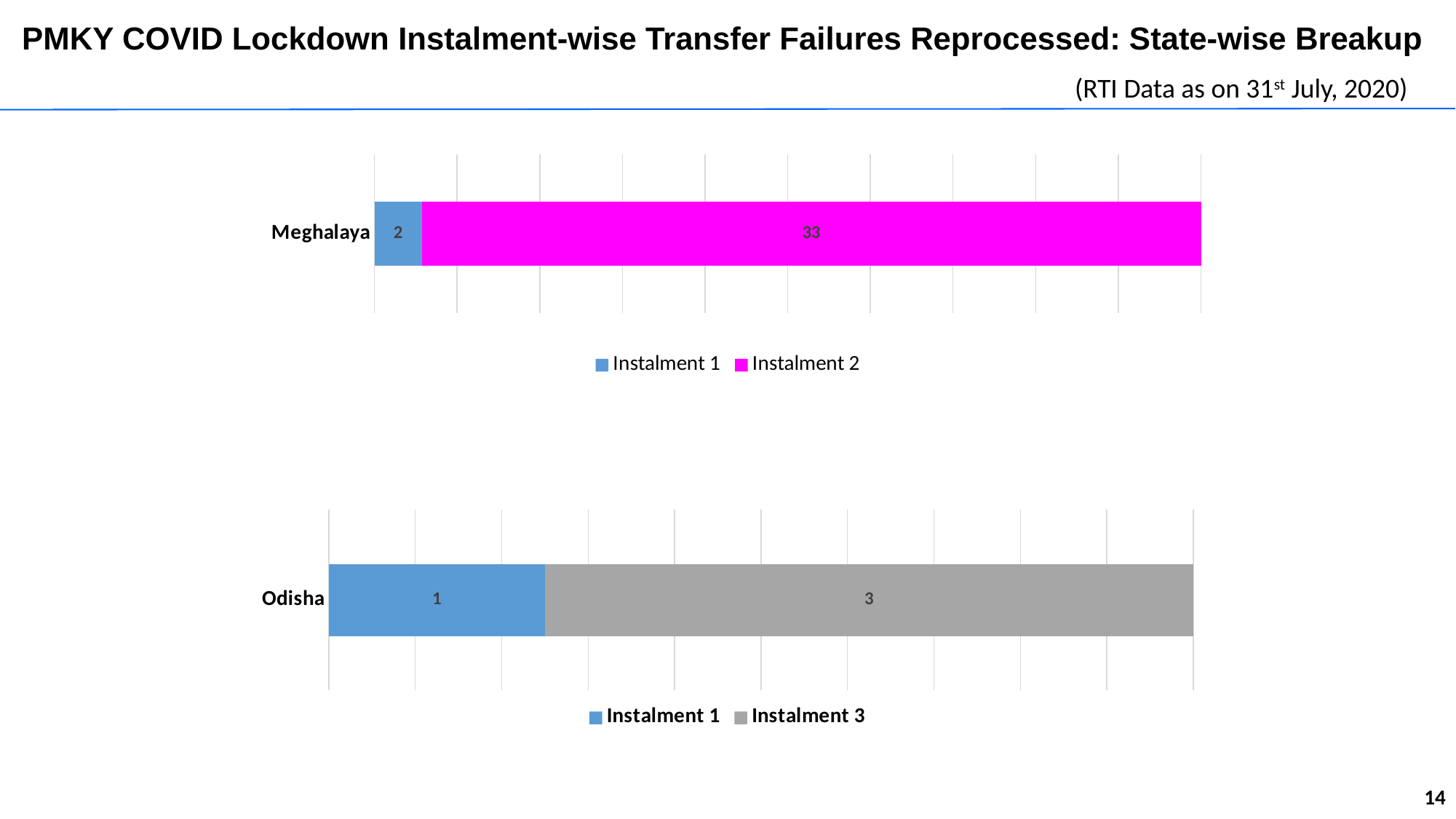
In the top chart (Meghalaya), what is the value for Instalment 1? 2 In the bottom chart (Odisha), what is the value for Instalment 1? 1 In the top chart (Meghalaya), which series has the highest value? Instalment 2 In the top chart (Meghalaya), what is the value for Instalment 2? 33 In the top chart (Meghalaya), what colour represents Instalment 2? Magenta In the bottom chart (Odisha), which is larger, Instalment 1 or Instalment 3? Instalment 3 How many series does the legend of the bottom chart (Odisha) list? 2 In the top chart (Meghalaya), what is the total of the stacked bar? 35 In the bottom chart (Odisha), what is the total of the stacked bar? 4 In the bottom chart (Odisha), what is the value for Instalment 3? 3 In the top chart (Meghalaya), what is the difference between Instalment 2 and Instalment 1? 31 What kind of chart is the top chart (Meghalaya)? Stacked bar chart